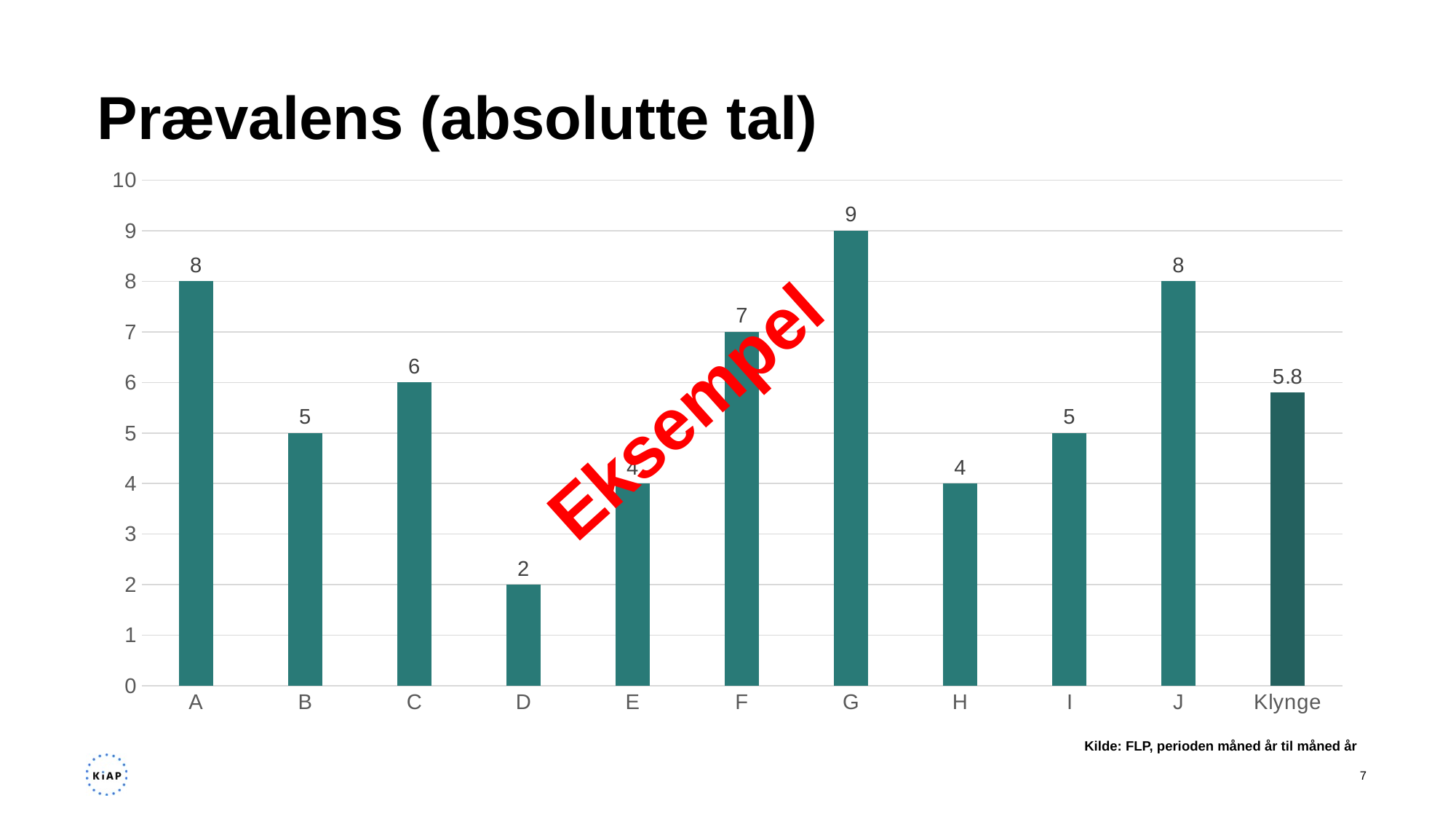
Which category has the highest value? G Which category has the lowest value? D What kind of chart is shown on the slide? bar chart How many categories are shown on the x axis? 11 What is the value for category G? 9 Which is larger, the value for C or the value for H? C Is the value for F greater or less than 5? greater What is the difference between the values for G and D? 7 What is the value for Klynge? 5.8 What is the value for category D? 2 What is the difference between the values for A and B? 3 What is the title of the slide? Prævalens (absolutte tal)